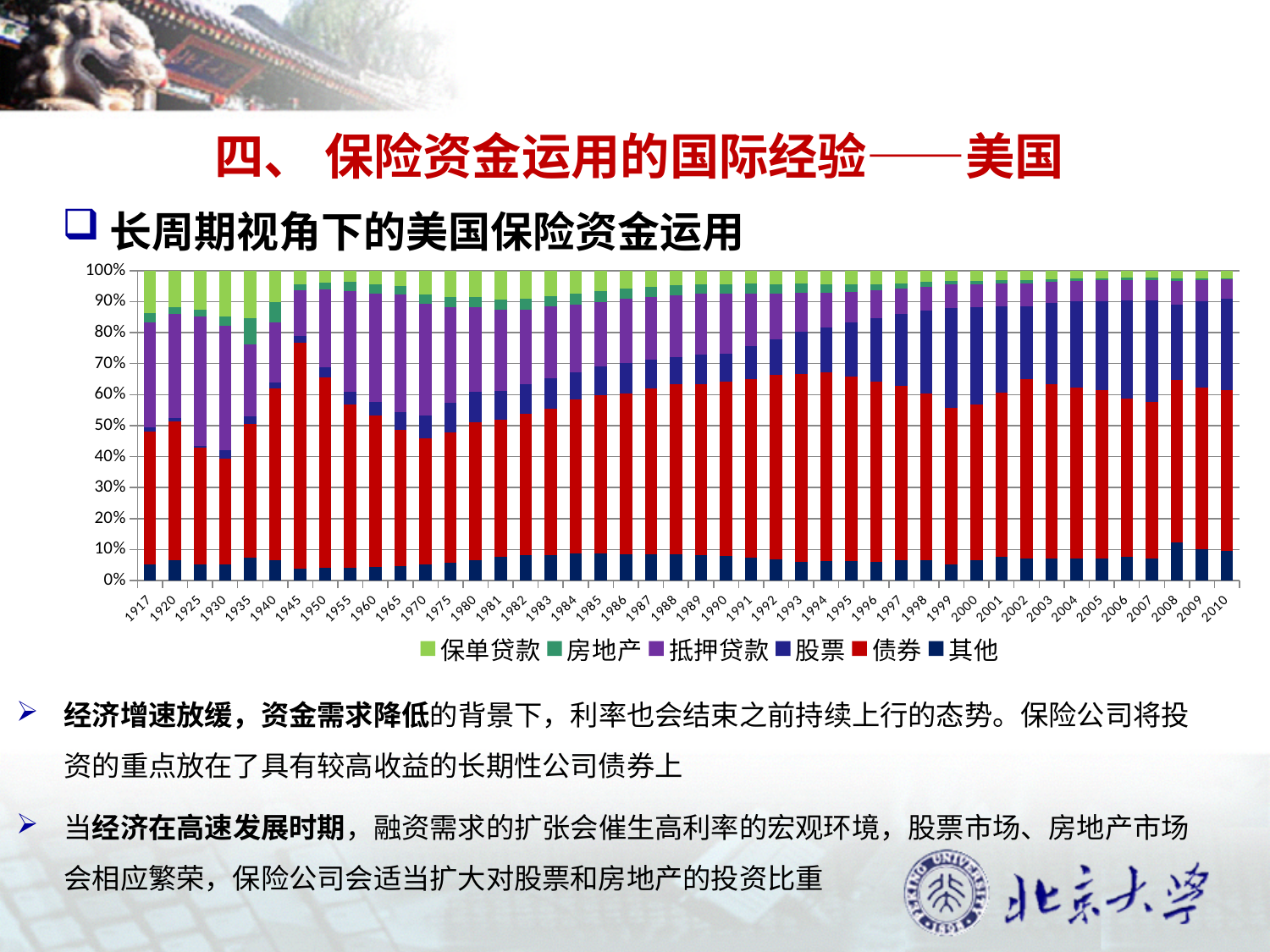
What kind of chart is shown on the slide? stacked bar chart Which series is shown in red in the chart? 债券 How many series does the chart legend list? 6 Which year has the highest 债券 share in the chart? 1945 Is the 抵押贷款 share larger in 1925 or in 2005? 1925 How many years are shown along the x axis of the chart? 44 Is the 抵押贷款 share in 2010 greater or less than 10%? less Is the 债券 share in 1945 greater or less than 50%? greater Is the 抵押贷款 share in 1930 greater or less than 30%? greater Does the 股票 share generally rise or fall from 1980 to 2010? rise What is the first year shown on the x axis of the chart? 1917